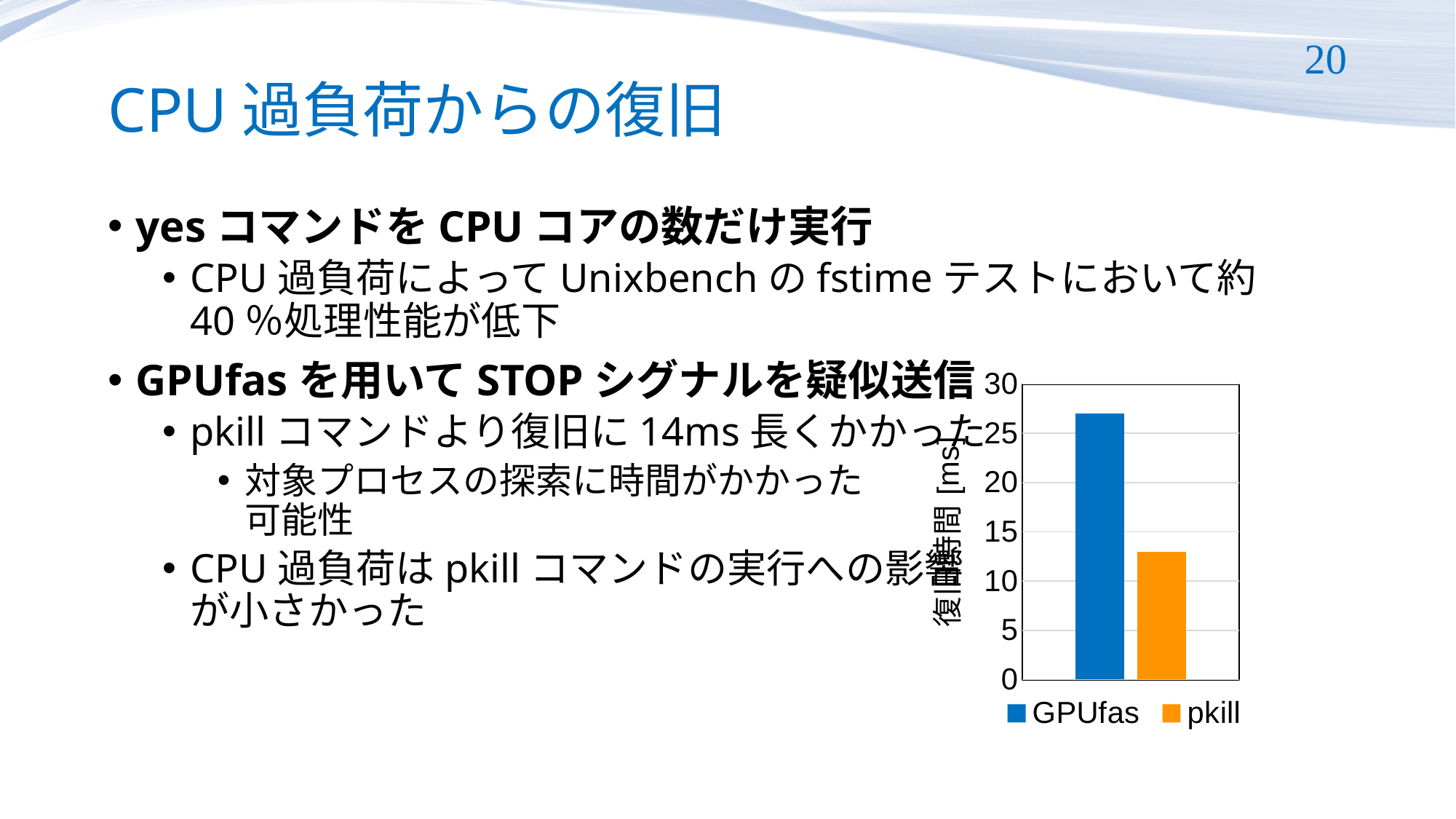
How many series does the chart's legend list? 2 Is the value for GPUfas greater or less than 30? less Is the value for pkill greater or less than 10? greater Is the value for GPUfas greater or less than 25? greater What kind of chart is shown on the slide? bar chart Which series has the highest value in the chart? GPUfas What colour is the bar for pkill? orange How many bars are plotted in the chart? 2 What is the label on the chart's vertical axis? 復旧時間 [ms] Which series has the taller bar, GPUfas or pkill? GPUfas Which series has the lowest value in the chart? pkill